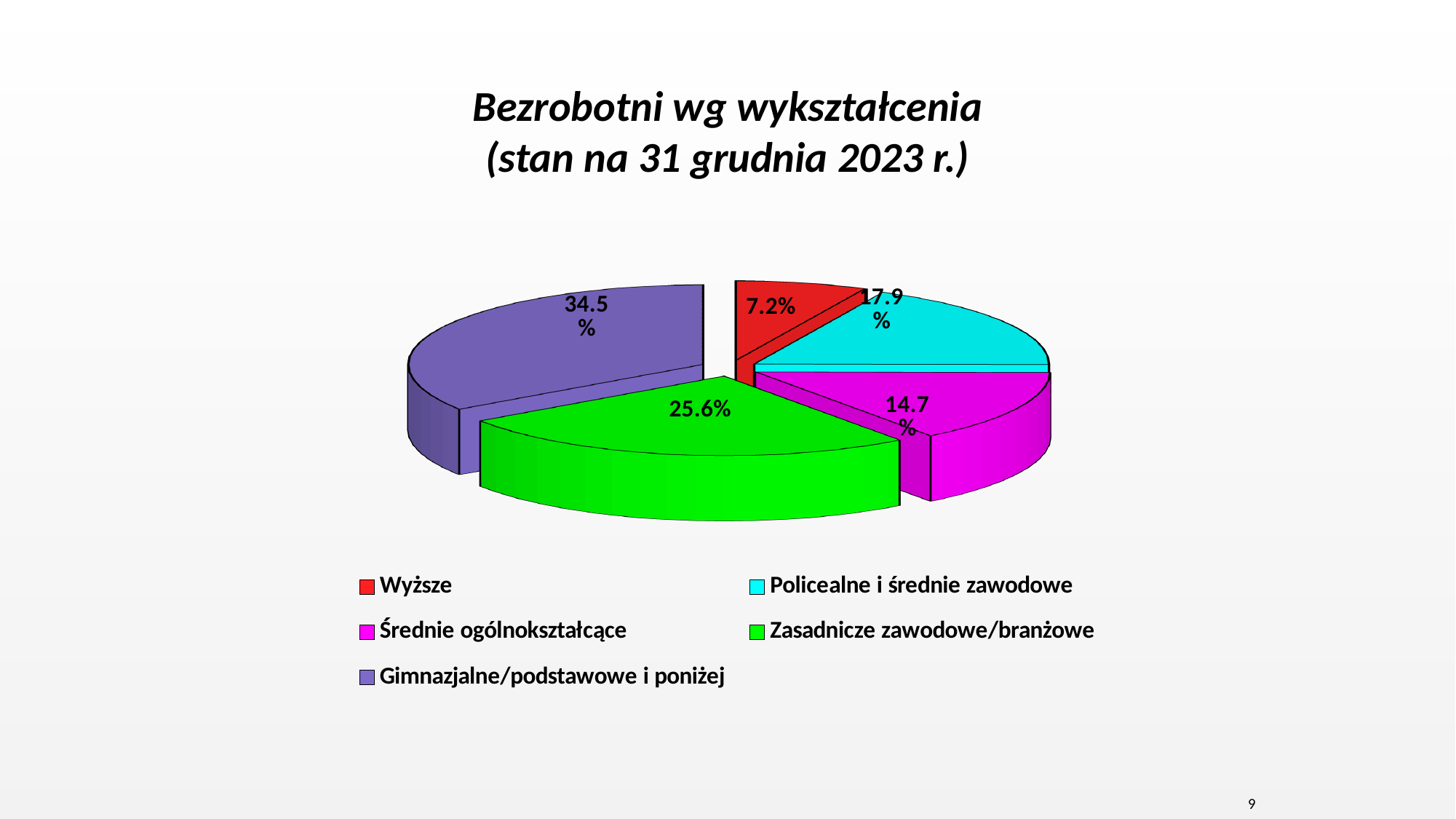
Which category has the smallest share of the pie? Wyższe Which category has the largest share of the pie? Gimnazjalne/podstawowe i poniżej What share of the pie does Średnie ogólnokształcące have? 14.7% What share of the pie does Zasadnicze zawodowe/branżowe have? 25.6% What share of the pie does Gimnazjalne/podstawowe i poniżej have? 34.5% Which is larger, the share for Policealne i średnie zawodowe or for Średnie ogólnokształcące? Policealne i średnie zawodowe What share of the pie does Wyższe have? 7.2% What kind of chart is shown on the slide? Pie chart What share of the pie does Policealne i średnie zawodowe have? 17.9% What is the difference in percentage points between Gimnazjalne/podstawowe i poniżej and Zasadnicze zawodowe/branżowe? 8.9 What is the title of the chart? Bezrobotni wg wykształcenia (stan na 31 grudnia 2023 r.) How many categories does the pie chart show? 5